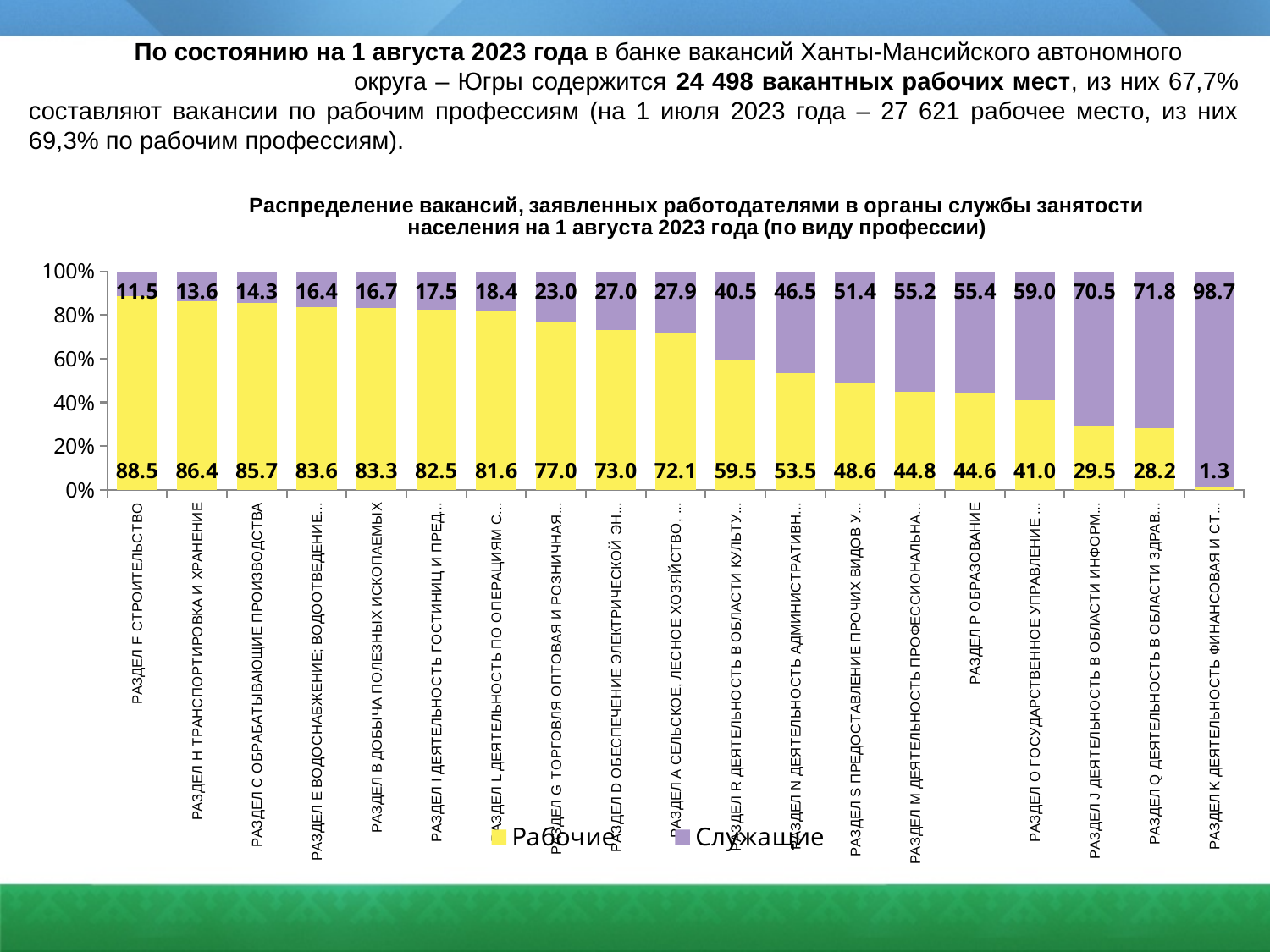
How many series does the legend list? 2 How many categories (sections) are shown on the x axis? 19 What is the value for Рабочие in РАЗДЕЛ B ДОБЫЧА ПОЛЕЗНЫХ ИСКОПАЕМЫХ? 83.3 What kind of chart is shown on the slide? Stacked bar chart What is the value for Рабочие in РАЗДЕЛ F СТРОИТЕЛЬСТВО? 88.5 Which colour represents the Служащие series? Purple What is the difference between the Рабочие values for РАЗДЕЛ F СТРОИТЕЛЬСТВО and РАЗДЕЛ H ТРАНСПОРТИРОВКА И ХРАНЕНИЕ? 2.1 Which is larger: the Рабочие value for РАЗДЕЛ C ОБРАБАТЫВАЮЩИЕ ПРОИЗВОДСТВА or for РАЗДЕЛ P ОБРАЗОВАНИЕ? РАЗДЕЛ C ОБРАБАТЫВАЮЩИЕ ПРОИЗВОДСТВА What is the value for Служащие in РАЗДЕЛ P ОБРАЗОВАНИЕ? 55.4 Do the Рабочие values rise or fall from left to right along the x axis? Fall Which category has the lowest value for Рабочие? РАЗДЕЛ K ДЕЯТЕЛЬНОСТЬ ФИНАНСОВАЯ И СТ... Which category has the highest value for Служащие? РАЗДЕЛ K ДЕЯТЕЛЬНОСТЬ ФИНАНСОВАЯ И СТ...